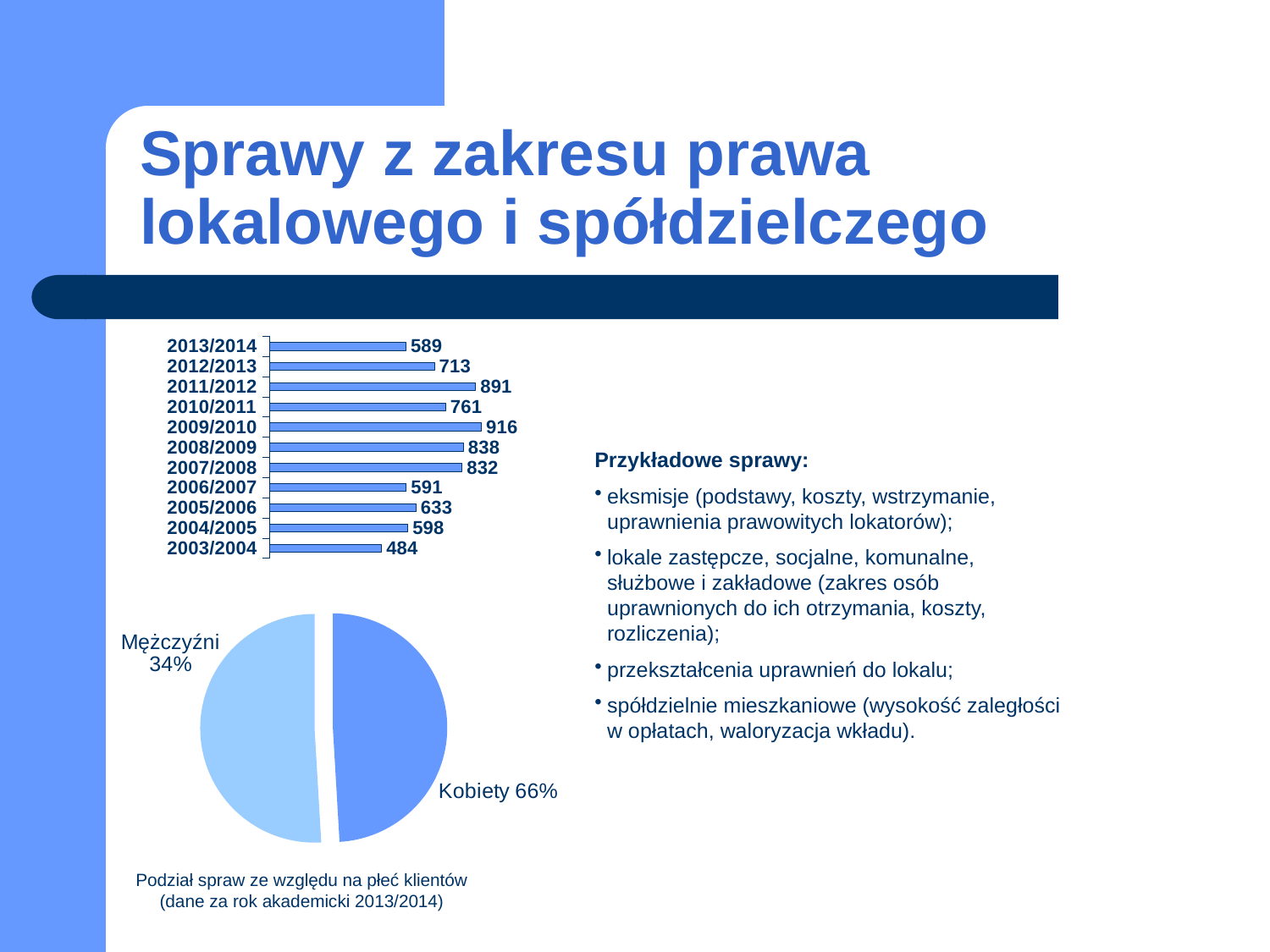
What kind of chart is the chart at the top left of the slide? Bar chart In the pie chart at the bottom left, what share is labelled Kobiety? 66% In the bar chart at the top left, which academic year has the lowest value? 2003/2004 In the bar chart at the top left, which academic year has the highest value? 2009/2010 In the bar chart at the top left, what is the value for 2013/2014? 589 In the pie chart at the bottom left, what share is labelled Mężczyźni? 34% How many academic years are shown in the bar chart at the top left? 11 In the bar chart at the top left, what is the value for 2003/2004? 484 In the bar chart at the top left, which is larger: the value for 2008/2009 or the value for 2007/2008? 2008/2009 In the bar chart at the top left, what is the difference between the values for 2011/2012 and 2012/2013? 178 In the bar chart at the top left, what is the value for 2009/2010? 916 What kind of chart is the chart at the bottom left of the slide? Pie chart